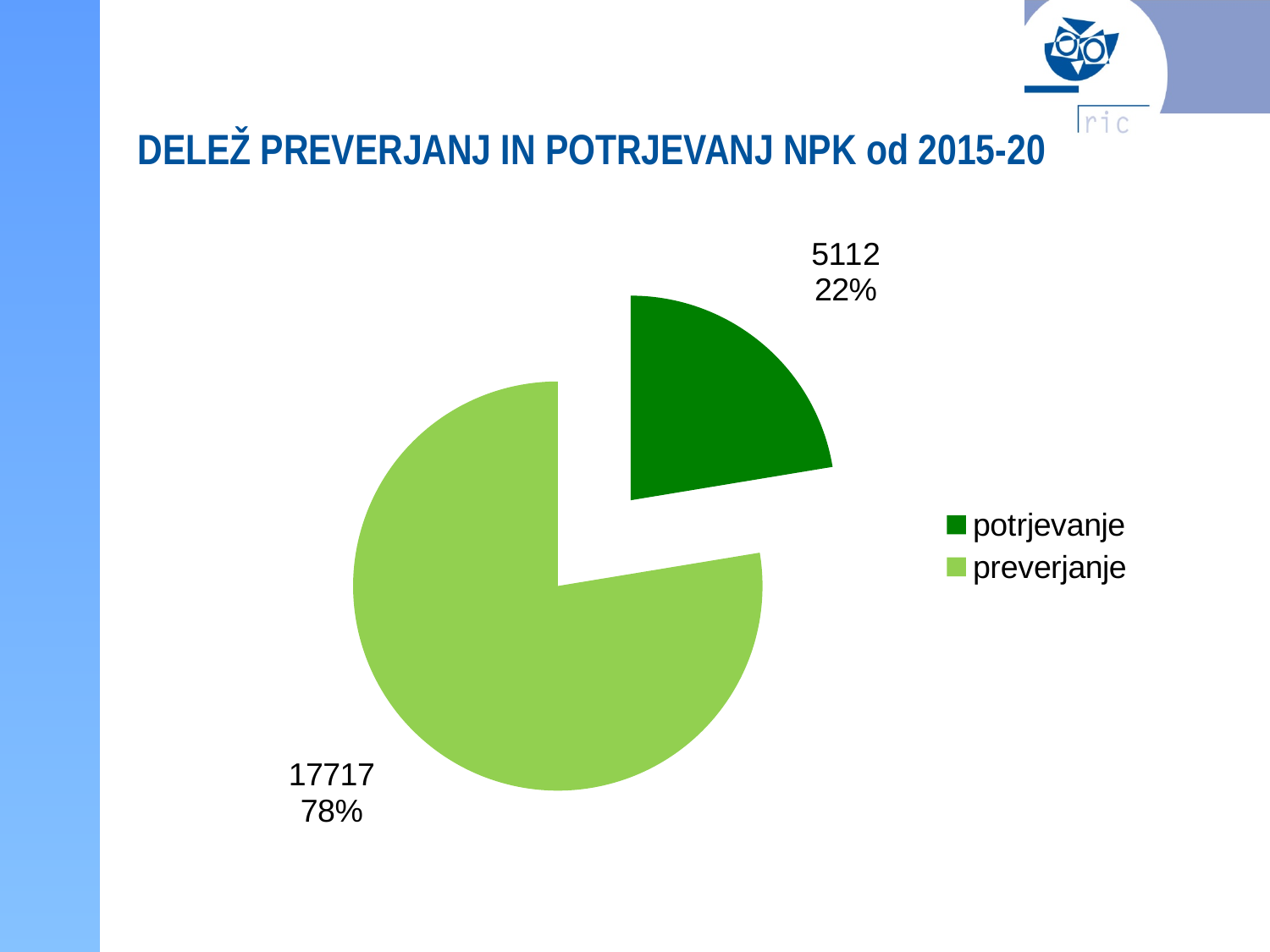
What share of the pie does preverjanje represent? 78% How many categories does the pie chart have? 2 What is the title of the slide containing the chart? DELEŽ PREVERJANJ IN POTRJEVANJ NPK od 2015-20 What kind of chart is shown on the slide? pie chart What is the value for potrjevanje? 5112 Which is larger, the value for potrjevanje or the value for preverjanje? preverjanje Which category has the largest slice? preverjanje Which category has the smallest slice? potrjevanje What is the total of the two values shown in the pie chart? 22829 What is the value for preverjanje? 17717 What is the difference between the values for preverjanje and potrjevanje? 12605 What share of the pie does potrjevanje represent? 22%